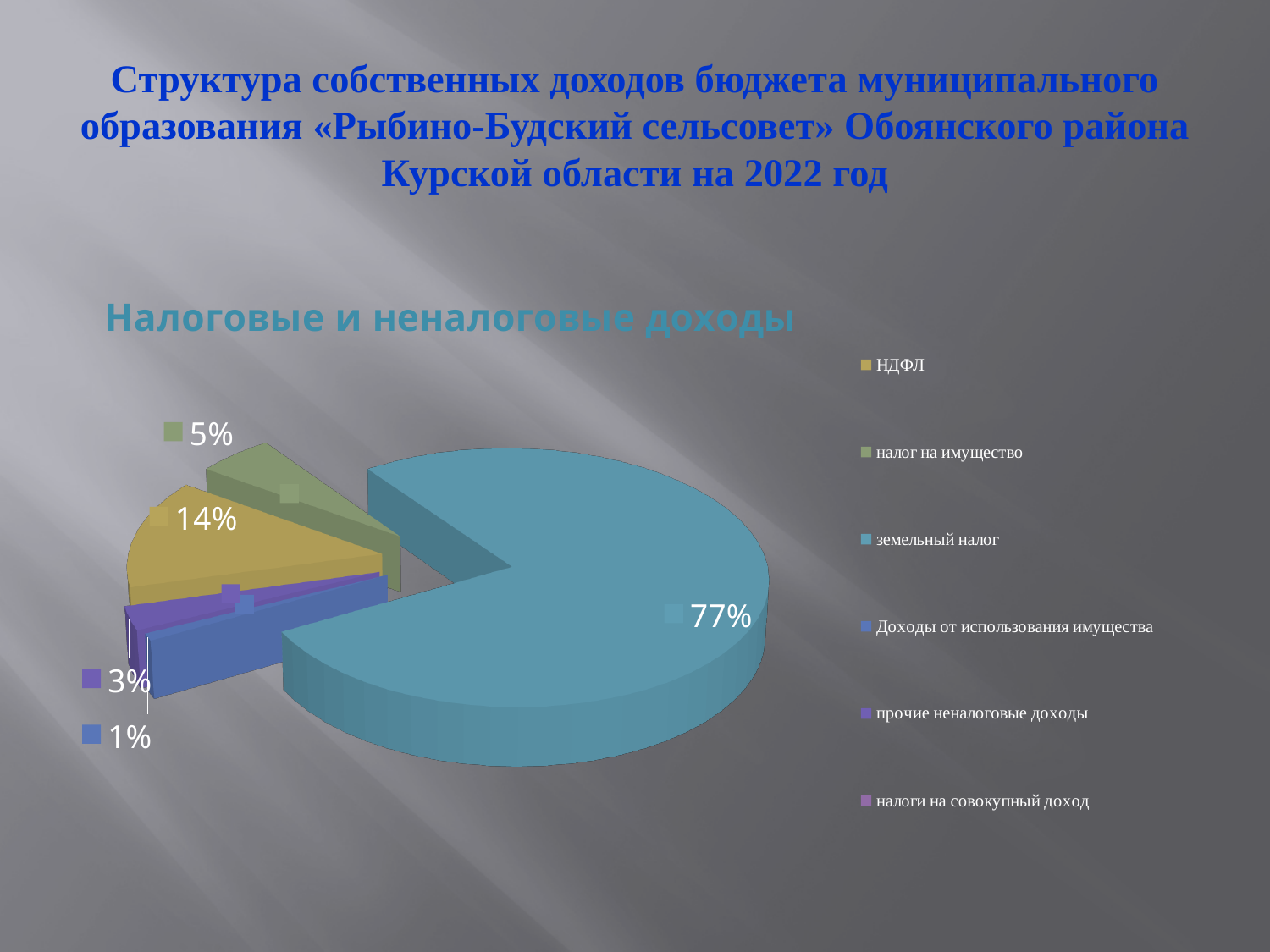
What is the difference in percentage points between земельный налог and НДФЛ? 63 percentage points What share of the pie does НДФЛ take? 14% What is the difference in percentage points between НДФЛ and налог на имущество? 9 percentage points How many percentage labels are shown on the pie chart? 5 What share of the pie does налог на имущество take? 5% Which category has the largest slice of the pie? земельный налог What share of the pie does земельный налог take? 77% What is the chart's title? Налоговые и неналоговые доходы What kind of chart is shown on the slide? pie chart How many entries does the legend list? 6 Which is larger, the share for НДФЛ or the share for налог на имущество? НДФЛ What is the smallest percentage label shown on the chart? 1%